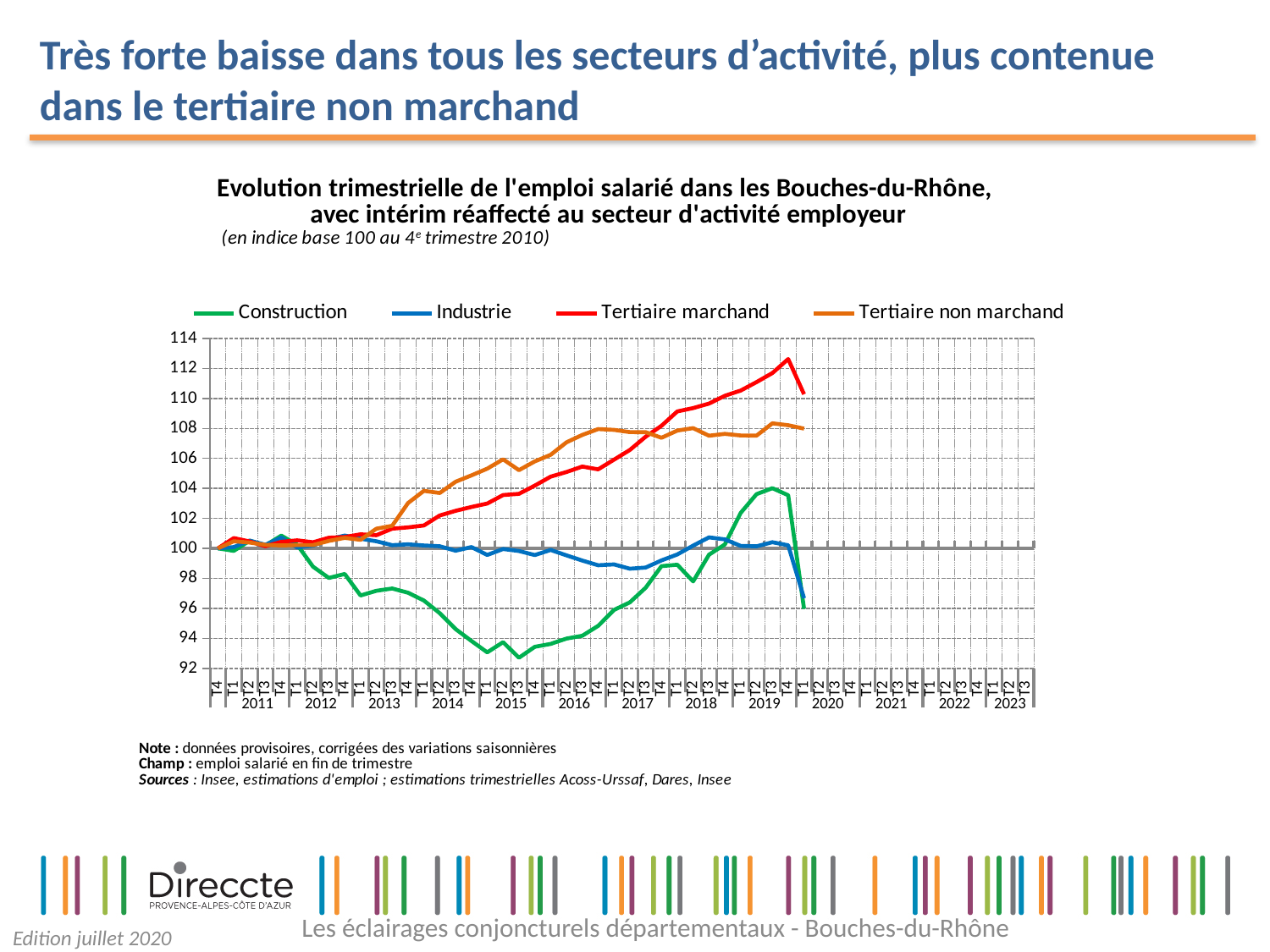
Is the value for Industrie at T1 2020 greater or less than 98? less Which series is drawn in red in the legend? Tertiaire marchand Is the value for Construction at T3 2019 greater or less than 102? greater Is the value for Tertiaire marchand at T4 2019 greater or less than 110? greater At T1 2020, is the value for Tertiaire marchand or Tertiaire non marchand larger? Tertiaire marchand Which series is drawn in green in the legend? Construction Which series has the lowest value in 2015? Construction What kind of chart is shown on the slide? line chart How many series does the legend list? 4 Does the Tertiaire marchand series rise or fall between 2011 and 2019? rise Which series has the highest value at the last plotted point (T1 2020)? Tertiaire marchand